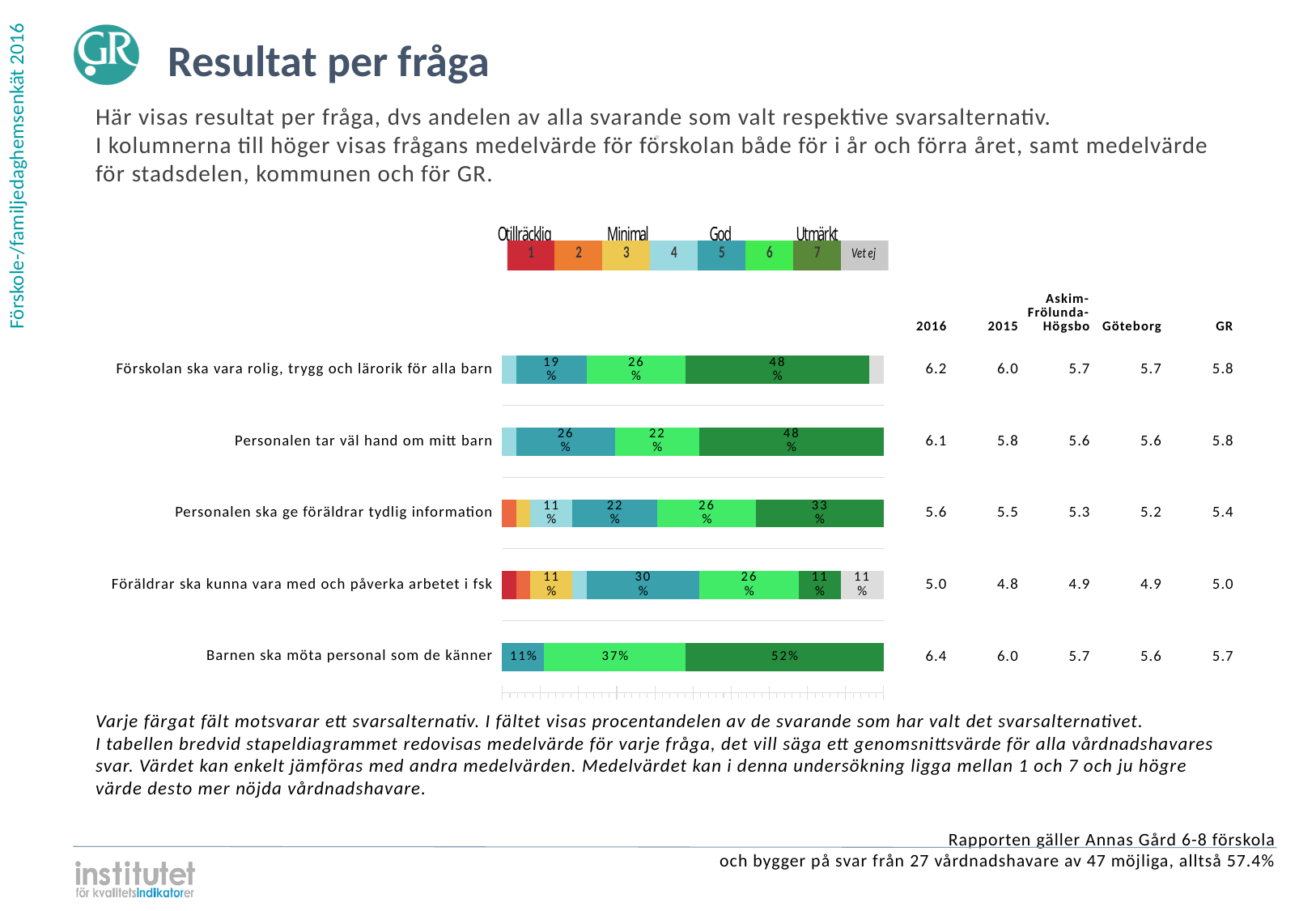
What percentage chose 5 for "Föräldrar ska kunna vara med och påverka arbetet i fsk"? 30% What percentage chose 5 for "Personalen tar väl hand om mitt barn"? 26% Which has a larger share choosing 6: "Barnen ska möta personal som de känner" or "Personalen ska ge föräldrar tydlig information"? Barnen ska möta personal som de känner What percentage answered "Vet ej" for "Föräldrar ska kunna vara med och påverka arbetet i fsk"? 11% What percentage chose 6 for "Förskolan ska vara rolig, trygg och lärorik för alla barn"? 26% How many percentage points higher is the share choosing 7 for "Förskolan ska vara rolig, trygg och lärorik för alla barn" than for "Personalen ska ge föräldrar tydlig information"? 15 percentage points How many questions (bars) are shown in the chart? 5 Which question has the smallest share of respondents choosing 7 (Utmärkt)? Föräldrar ska kunna vara med och påverka arbetet i fsk What percentage of respondents chose 7 (Utmärkt) for "Barnen ska möta personal som de känner"? 52% What percentage chose 7 for "Personalen ska ge föräldrar tydlig information"? 33% Which question has the largest share of respondents choosing 7 (Utmärkt)? Barnen ska möta personal som de känner What type of chart is shown on the slide? Stacked bar chart